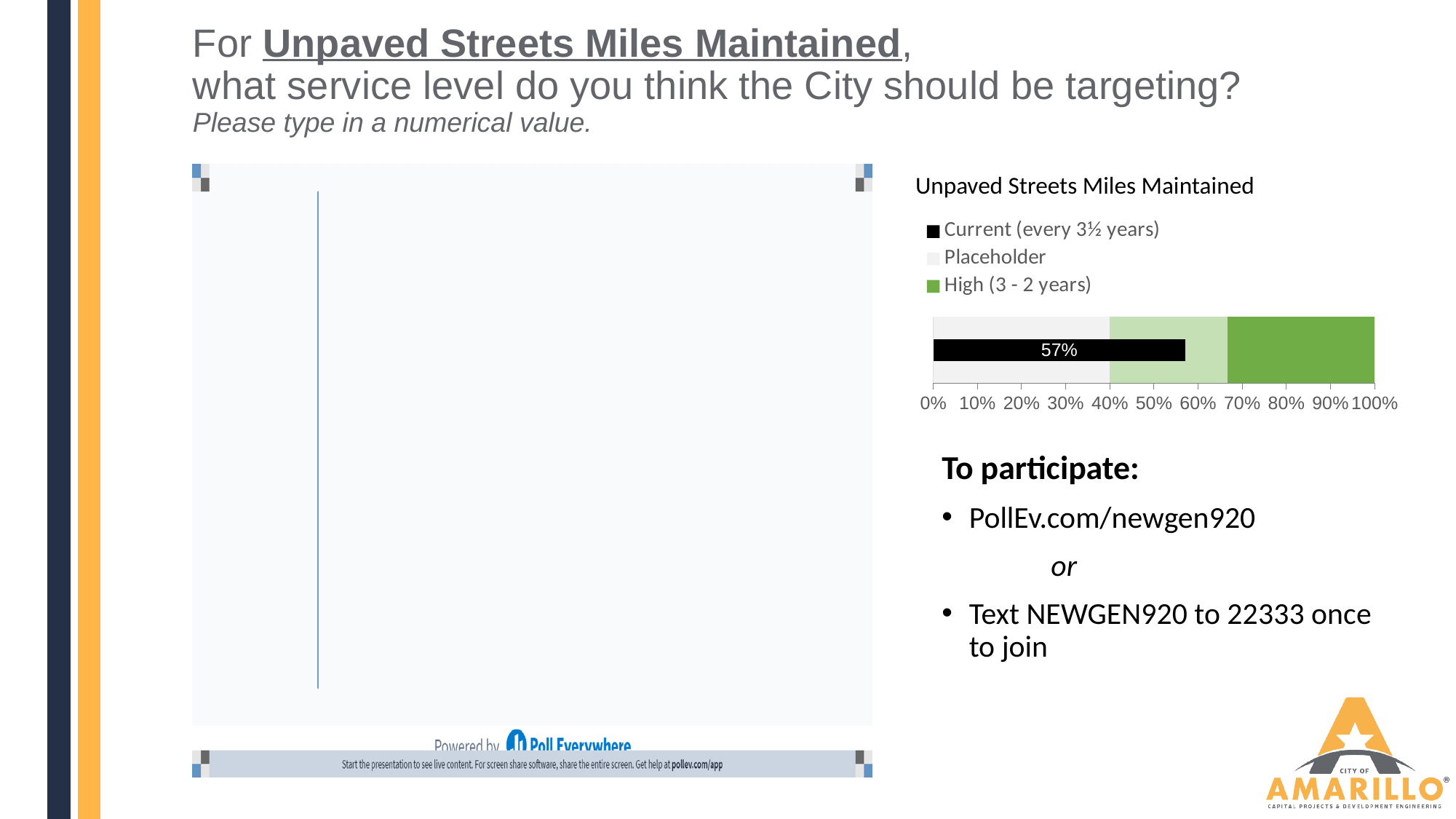
Is the value of the Current bar in the Unpaved Streets Miles Maintained chart greater or less than 60%? less What value is shown on the black bar in the Unpaved Streets Miles Maintained chart? 57% Which legend entry in the Unpaved Streets Miles Maintained chart is shown in black? Current (every 3½ years) Is the value of the Current bar in the Unpaved Streets Miles Maintained chart greater or less than 50%? greater What kind of chart is the Unpaved Streets Miles Maintained chart? bar chart How many data-labelled bars are plotted in the Unpaved Streets Miles Maintained chart? 1 What is the highest value shown on the x axis of the Unpaved Streets Miles Maintained chart? 100% What is the title of the chart on the right side of the slide? Unpaved Streets Miles Maintained How many series does the legend of the Unpaved Streets Miles Maintained chart list? 3